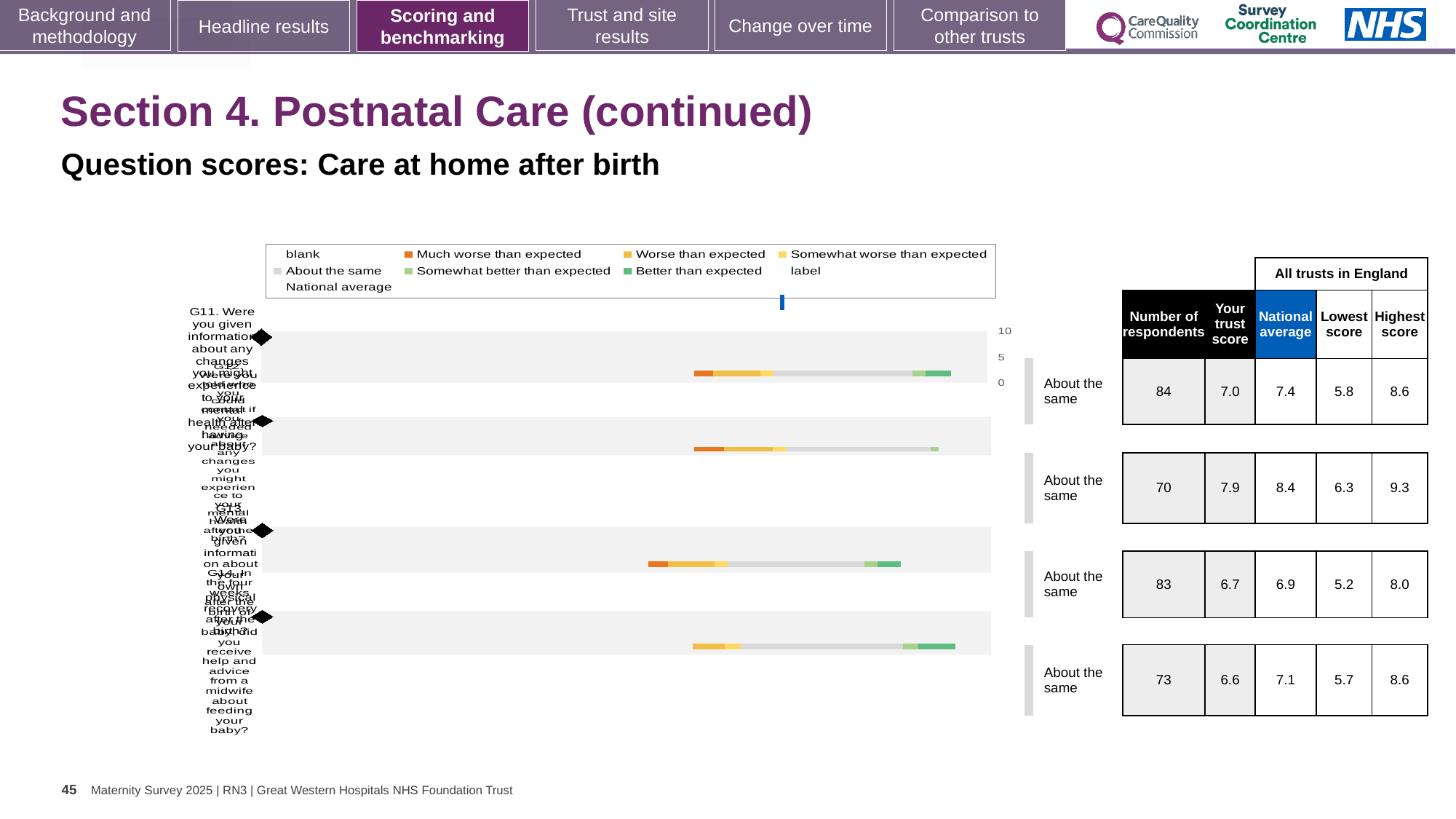
How many question rows (bars) are plotted in the chart? 4 In the table beside the chart, what is the national average for the third question row? 6.9 What colour represents 'Better than expected' in the chart legend? green What colour represents 'Much worse than expected' in the chart legend? orange What benchmark category is shown for all four question rows next to the chart? About the same In the table beside the chart, what is the number of respondents for the first (top) question row? 84 For the top question row, which is larger: the trust score or the national average? national average What kind of chart is shown on the slide? bar chart In the table beside the chart, which question row has the highest 'Highest score' value? the second row (9.3) How many entries does the chart legend list? 9 For the top question row, what is the difference between the national average (7.4) and the trust score (7.0)? 0.4 In the table beside the chart, what is the trust score for the second question row? 7.9